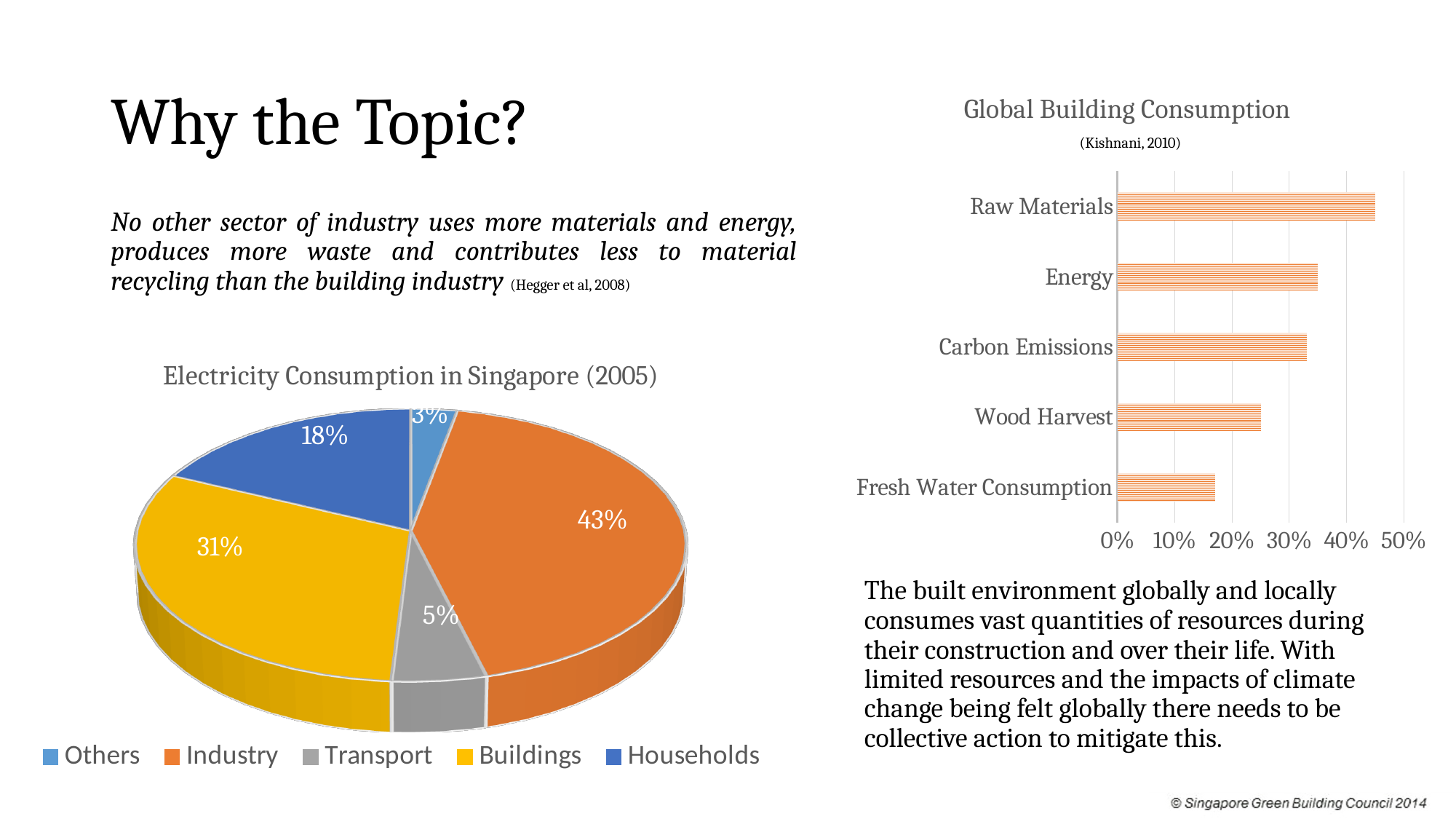
What kind of chart is the Electricity Consumption in Singapore (2005) chart? Pie chart In the Global Building Consumption chart, which category has the highest value? Raw Materials In the Global Building Consumption chart, is the value for Raw Materials greater or less than 40%? greater In the Electricity Consumption in Singapore (2005) chart, what share does Industry have? 43% In the Electricity Consumption in Singapore (2005) chart, which category has the smallest share? Others In the Global Building Consumption chart, which category has the lowest value? Fresh Water Consumption In the Electricity Consumption in Singapore (2005) chart, which category has the largest share? Industry What kind of chart is the Global Building Consumption chart? Bar chart In the Electricity Consumption in Singapore (2005) chart, what share does Buildings have? 31% In the Electricity Consumption in Singapore (2005) chart, how many categories does the legend list? 5 In the Electricity Consumption in Singapore (2005) chart, how many percentage points larger is Industry than Buildings? 12 In the Electricity Consumption in Singapore (2005) chart, what share does Households have? 18%